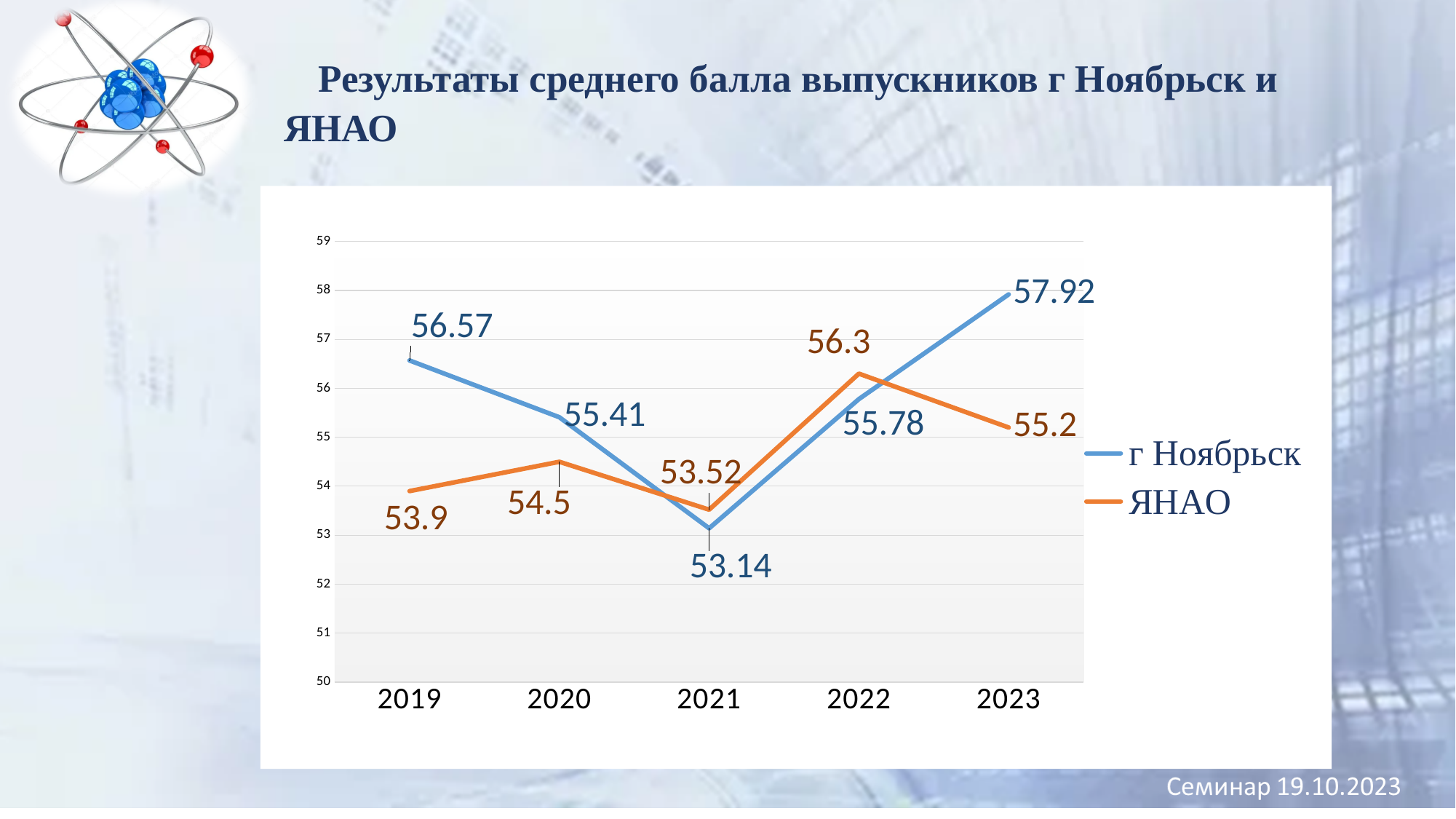
What type of chart is shown on the slide? line chart Does the value for г Ноябрьск rise or fall from 2019 to 2021? fall Which colour is used for the ЯНАО line? orange How many years are shown on the x axis? 5 What is the difference between г Ноябрьск and ЯНАО in 2023? 2.72 In which year is the value for ЯНАО highest? 2022 What is the value for г Ноябрьск in 2021? 53.14 What is the value for г Ноябрьск in 2023? 57.92 Which series has the larger value in 2022, г Ноябрьск or ЯНАО? ЯНАО What is the value for ЯНАО in 2019? 53.9 In which year is the value for г Ноябрьск lowest? 2021 How many series does the legend list? 2